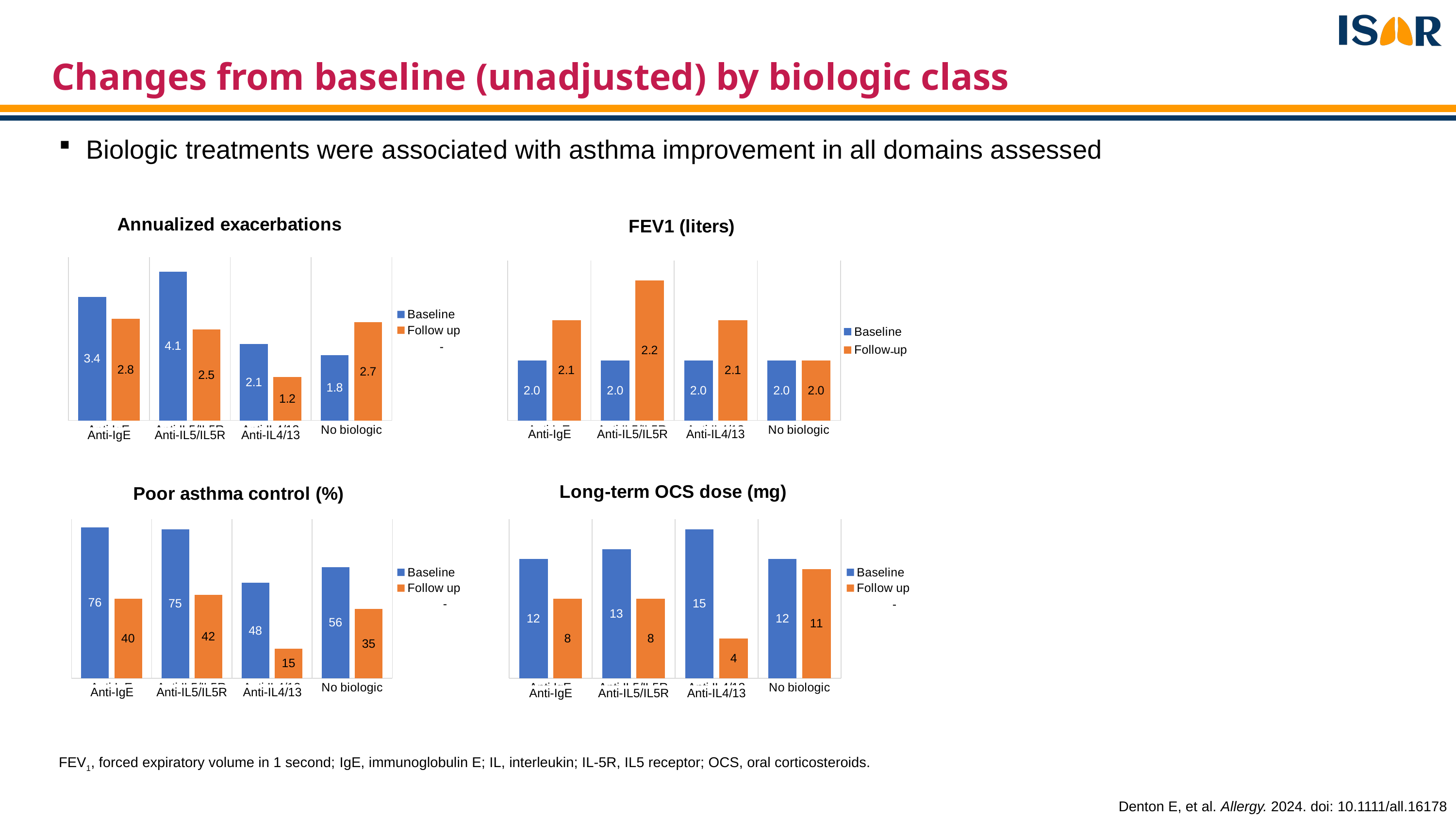
In the Annualized exacerbations chart, which category has the highest Baseline value? Anti-IL5/IL5R In the Poor asthma control (%) chart, what is the difference between the Baseline and Follow up values for Anti-IgE? 36 In the Annualized exacerbations chart, what is the Follow up value for Anti-IL4/13? 1.2 In the FEV1 (liters) chart, which category has the highest Follow-up value? Anti-IL5/IL5R In the Poor asthma control (%) chart, which category has the lowest Follow up value? Anti-IL4/13 In the Long-term OCS dose (mg) chart, what is the Baseline value for Anti-IL4/13? 15 In the Long-term OCS dose (mg) chart, which is larger, the Follow up value for No biologic or the Follow up value for Anti-IgE? No biologic In the Poor asthma control (%) chart, what is the Follow up value for No biologic? 35 In the FEV1 (liters) chart, what is the Follow-up value for Anti-IL5/IL5R? 2.2 In the Annualized exacerbations chart, what is the Baseline value for Anti-IL5/IL5R? 4.1 How many series does the legend of the Annualized exacerbations chart list? 2 How many categories are shown on the x axis of the Long-term OCS dose (mg) chart? 4